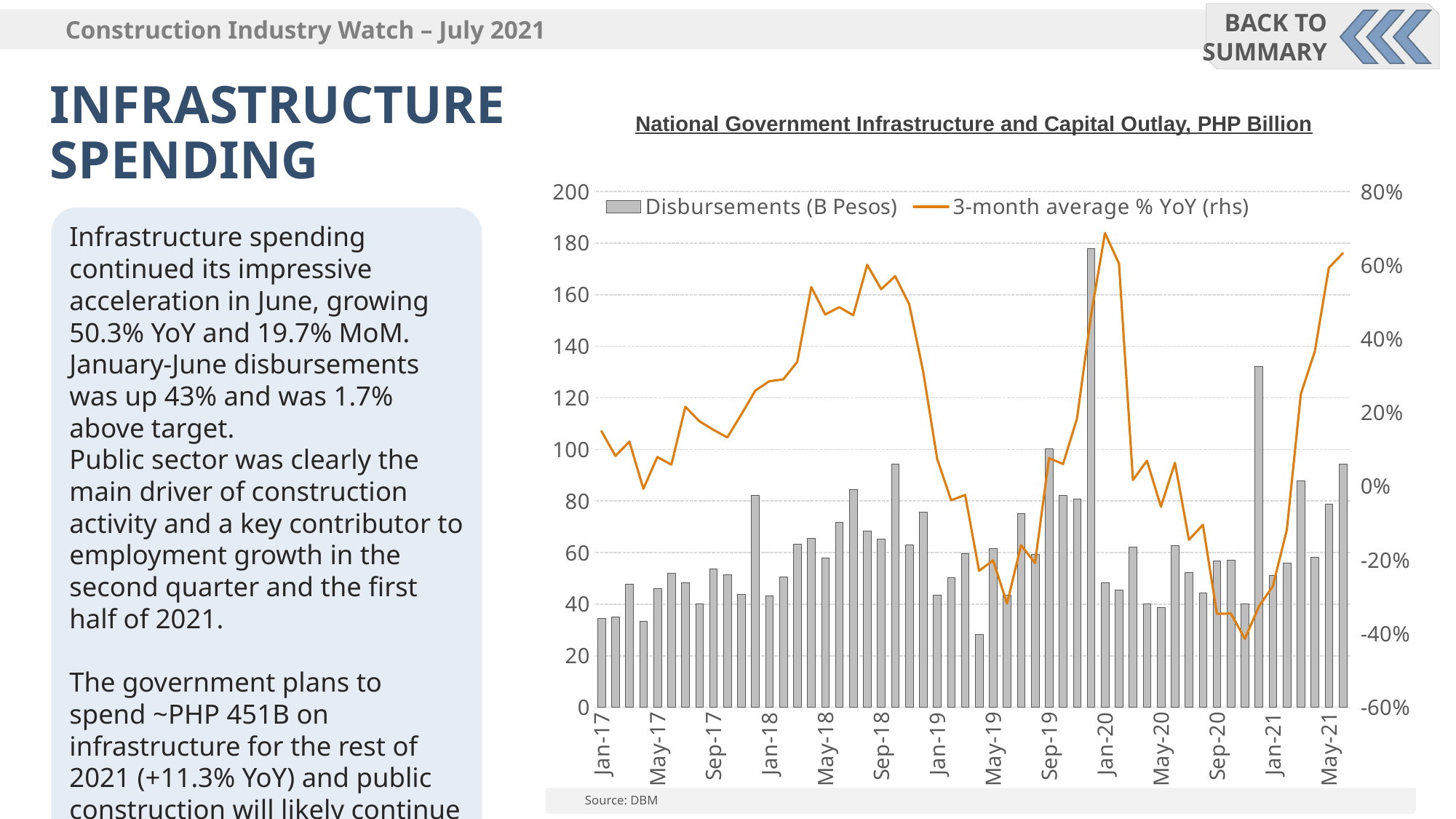
Is the Disbursements bar for Jan-20 greater or less than 60? less What kind of chart is shown on the slide? A combined bar and line chart Is the Disbursements bar for Jan-18 greater or less than 60? less Is the 3-month average % YoY line for Sep-18 greater or less than 40%? greater What is the title of the chart? National Government Infrastructure and Capital Outlay, PHP Billion Does the 3-month average % YoY line rise or fall between Jan-21 and May-21? rise What is the source cited below the chart? DBM How many month labels are shown on the x axis? 14 How many series does the legend list? 2